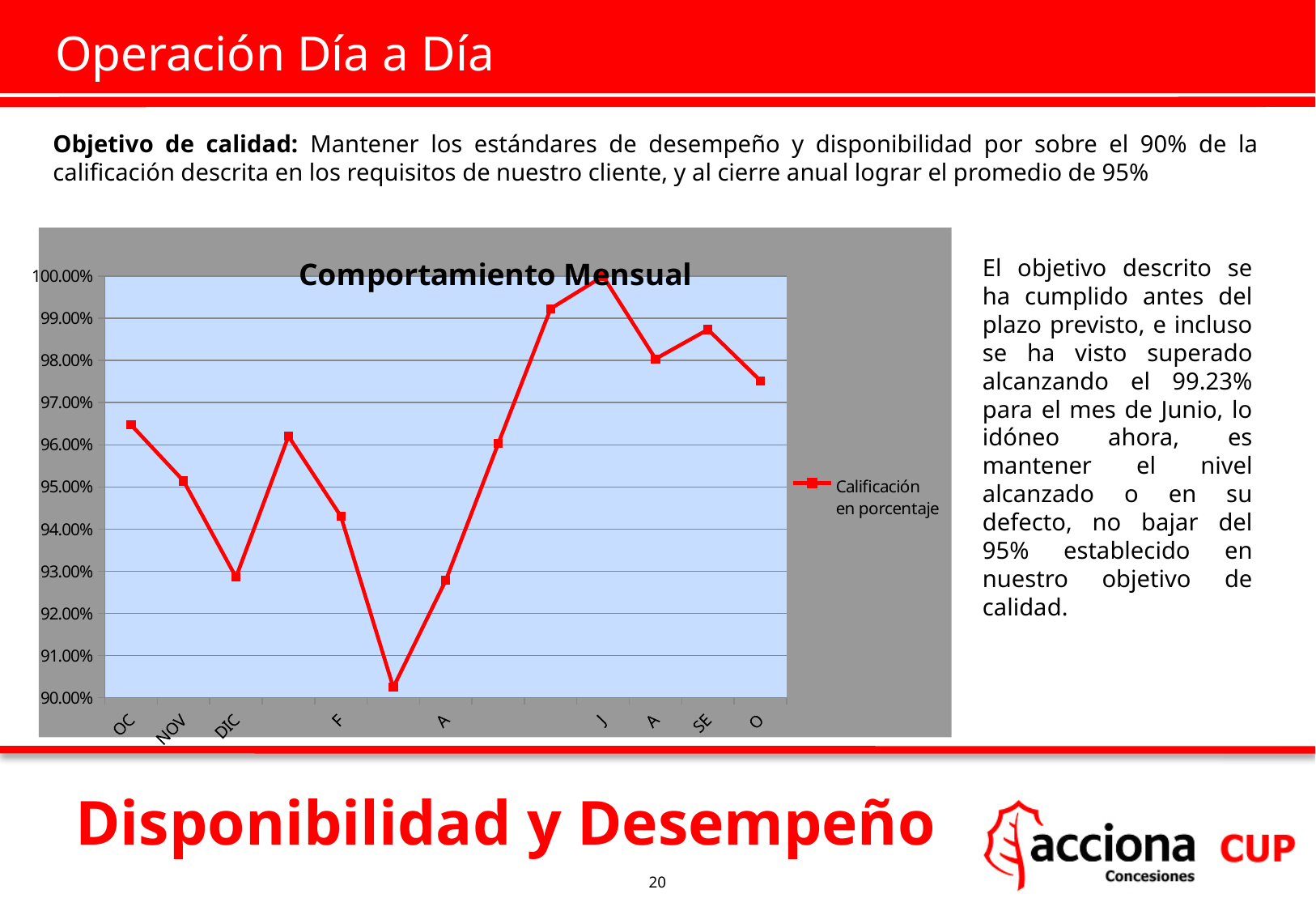
What is the title of the chart? Comportamiento Mensual What kind of chart is shown on the slide? line chart Is the value for F greater or less than 95.00%? less How many data points are plotted on the line? 13 Which is larger, the value for DIC or the value for F? F What is the name of the series shown in the legend? Calificación en porcentaje Which is larger, the value for OC or the value for NOV? OC How many series does the chart legend list? 1 Is the value for SE greater or less than 98.00%? greater Is the value for OC greater or less than 96.00%? greater Do the values rise or fall from OC to DIC? fall